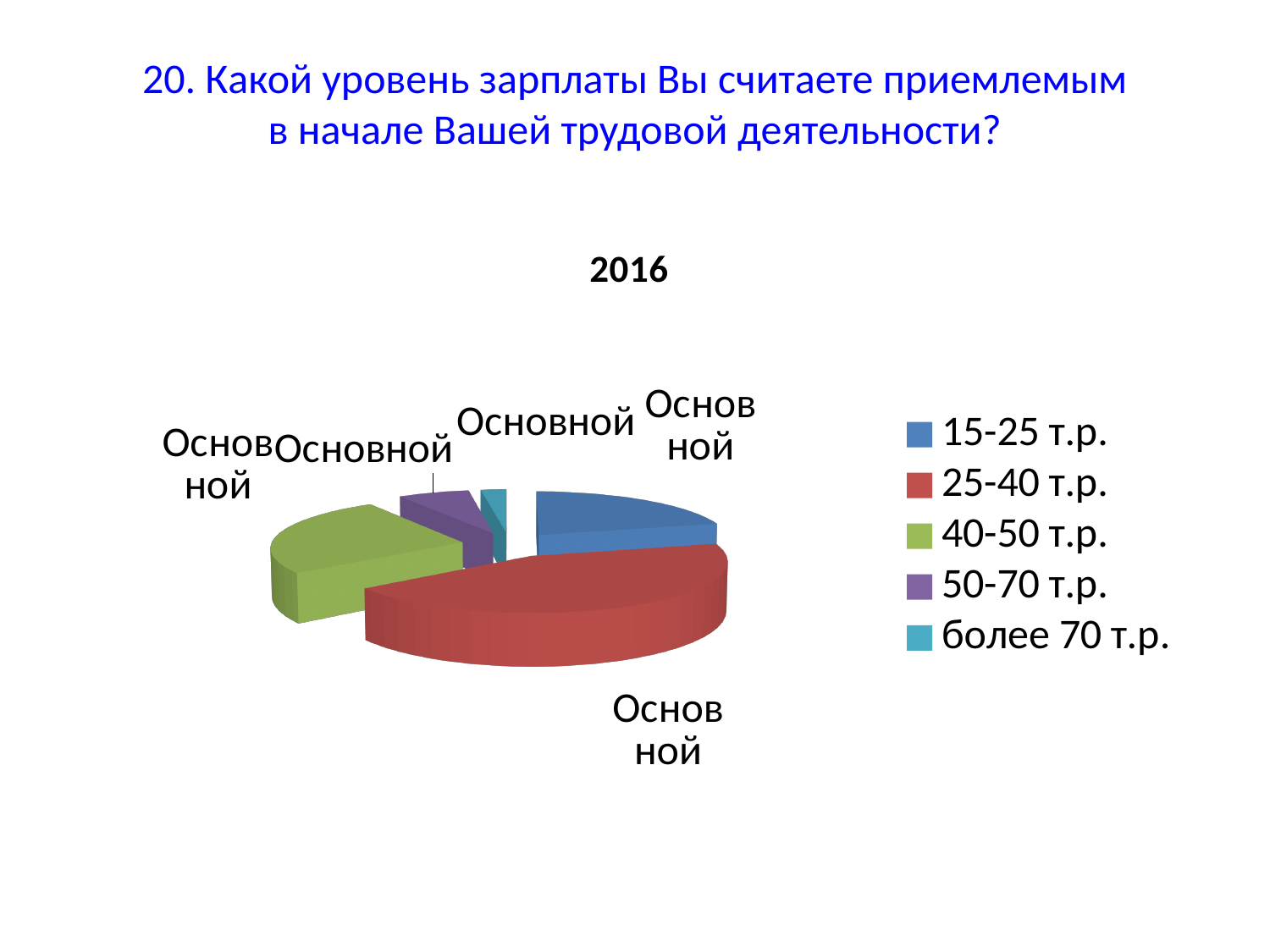
What is the title of the chart? 2016 Which slice is larger: 15-25 т.р. or более 70 т.р.? 15-25 т.р. How many entries does the legend list? 5 Which slice is larger: 25-40 т.р. or 15-25 т.р.? 25-40 т.р. What colour is the slice for 40-50 т.р.? green Which salary range has the smallest slice of the pie? более 70 т.р. How many slices does the pie chart have? 5 Which slice is larger: 40-50 т.р. or 50-70 т.р.? 40-50 т.р. What kind of chart is shown on the slide? pie chart Which salary range has the largest slice of the pie? 25-40 т.р.